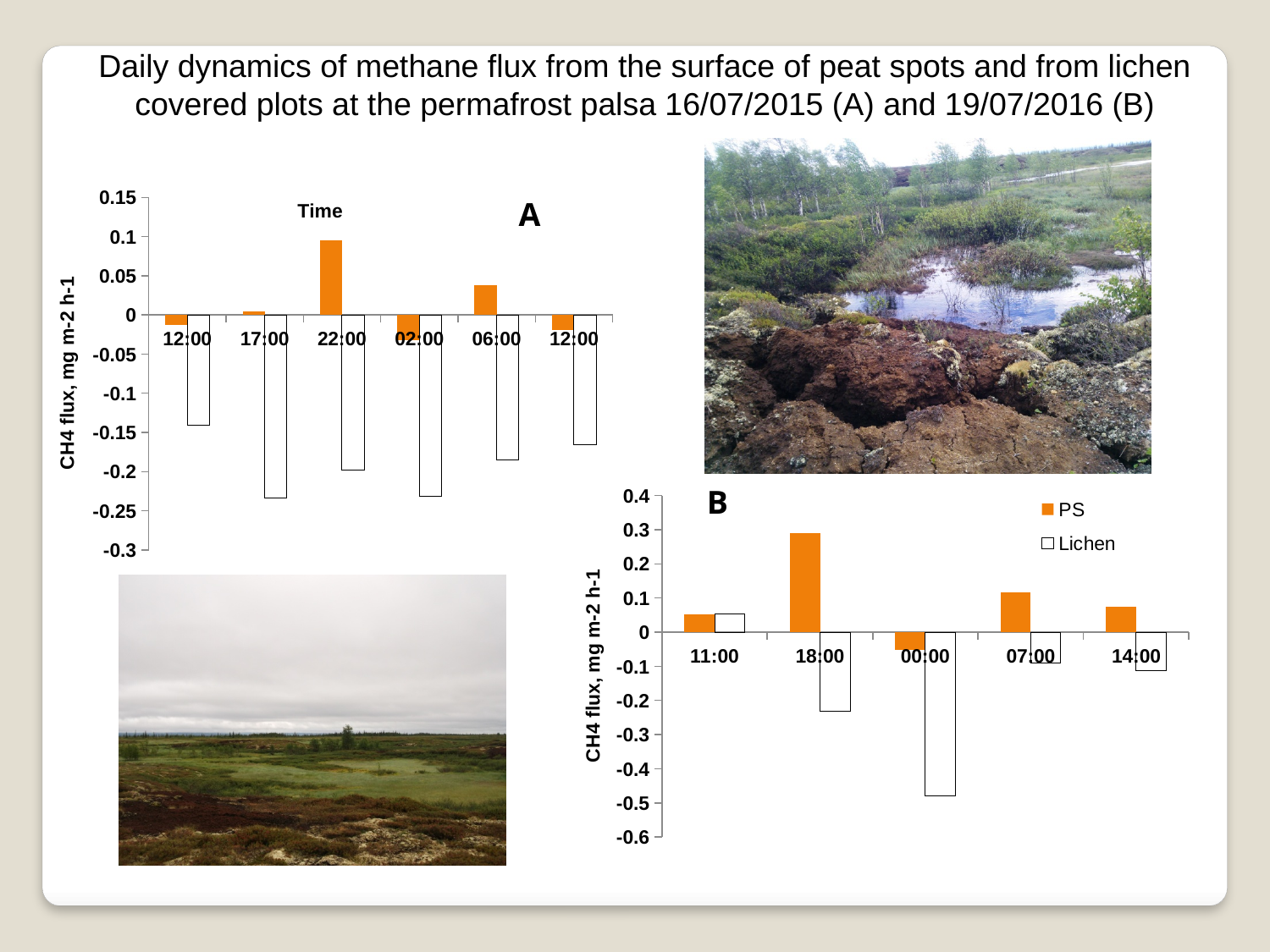
In chart A, is the orange bar value at 22:00 greater or less than 0.05? greater How many series does the legend of chart B list? 2 How many time points are shown on the x axis of chart B? 5 What are the two legend entries in chart B? PS and Lichen In chart A, at which time is the orange bar highest? 22:00 In chart B, at which time is the Lichen bar lowest? 00:00 In chart B, which is larger, the PS value at 18:00 or the PS value at 07:00? 18:00 In chart B, at which time is the PS bar highest? 18:00 How many time points are shown on the x axis of chart A? 6 In chart B, is the Lichen value at 00:00 greater or less than -0.4? less In chart B, is the PS value at 18:00 greater or less than 0.2? greater What kind of chart is chart B? bar chart